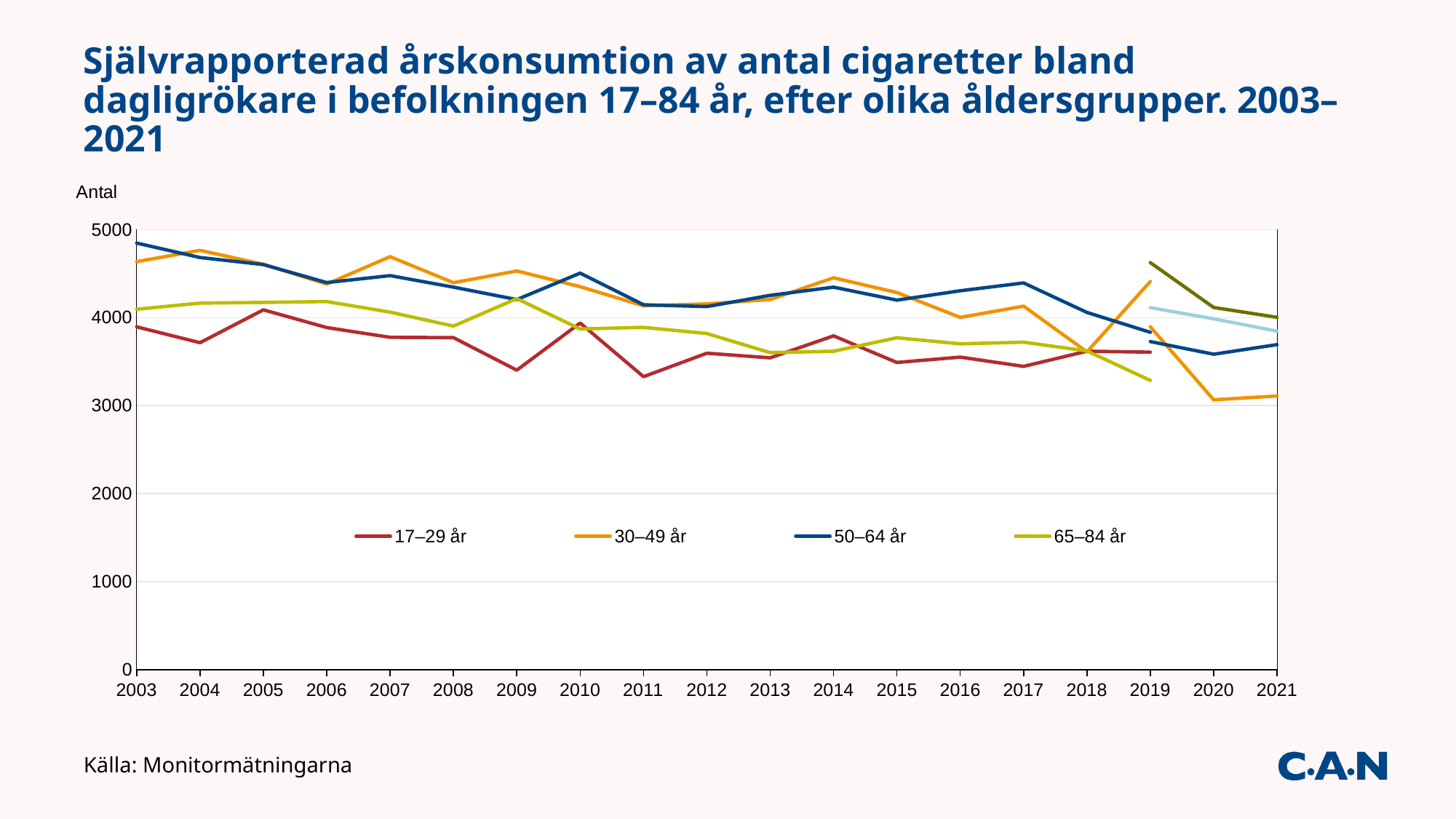
What is the label on the y axis? Antal How many years are shown along the x axis? 19 Which age group has the lowest value in 2021? 30–49 år Is the value for 30–49 år in 2020 greater or less than 4000? less In 2003, which is larger: the value for 17–29 år or the value for 50–64 år? 50–64 år In 2020, which is larger: the value for 30–49 år or the value for 50–64 år? 50–64 år Does the value for 30–49 år rise or fall from 2019 to 2021? Fall What kind of chart is shown on the slide? Line chart How many series does the legend list? 4 Is the value for 17–29 år in 2011 greater or less than 4000? less Which age group has the highest value in 2003? 50–64 år Is the value for 50–64 år in 2003 greater or less than 4000? greater